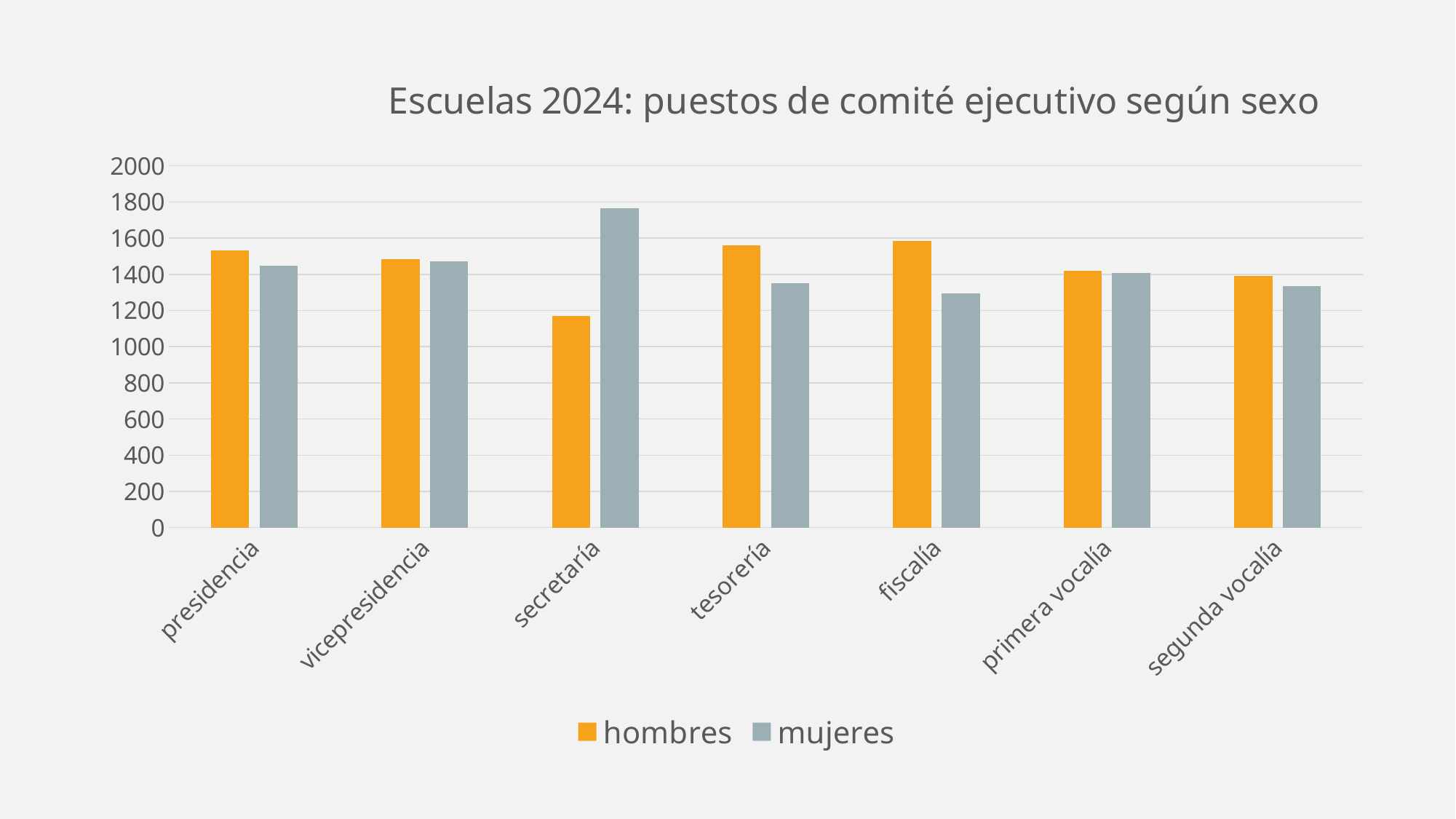
Is the value for hombres in presidencia greater or less than 1400? greater How many categories (puestos) are shown on the x axis? 7 In secretaría, which is larger: hombres or mujeres? mujeres Is the value for mujeres in secretaría greater or less than 1600? greater What kind of chart is shown on the slide? bar chart Which category has the highest value for mujeres? secretaría What is the title of the chart? Escuelas 2024: puestos de comité ejecutivo según sexo Is the value for mujeres in fiscalía greater or less than 1400? less In tesorería, which is larger: hombres or mujeres? hombres How many series does the legend list? 2 Which category has the lowest value for hombres? secretaría